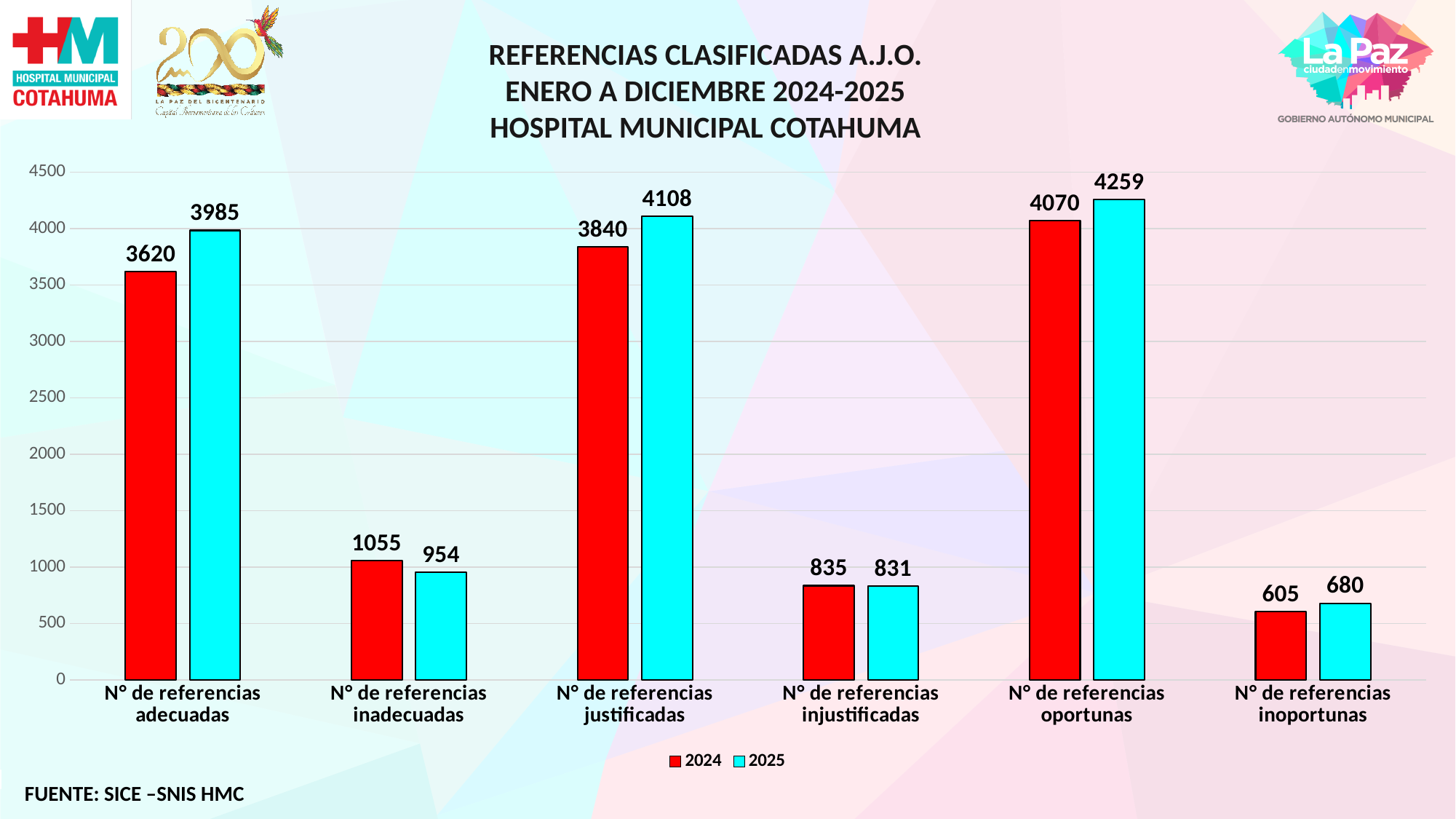
Which category has the lowest value in the 2024 series? N° de referencias inoportunas What is the difference between the 2024 and 2025 values for 'N° de referencias inadecuadas'? 101 What is the value for 'N° de referencias adecuadas' in 2024? 3620 Which is larger for 'N° de referencias inoportunas': the 2024 value or the 2025 value? 2025 Which category has the highest value in the 2025 series? N° de referencias oportunas What is the value for 'N° de referencias oportunas' in 2025? 4259 What is the difference between the 2025 and 2024 values for 'N° de referencias justificadas'? 268 What is the value for 'N° de referencias inadecuadas' in 2025? 954 Which colour represents the 2024 series in the legend? Red How many series does the legend list? 2 What kind of chart is shown on the slide? Bar chart How many categories are shown on the x axis? 6